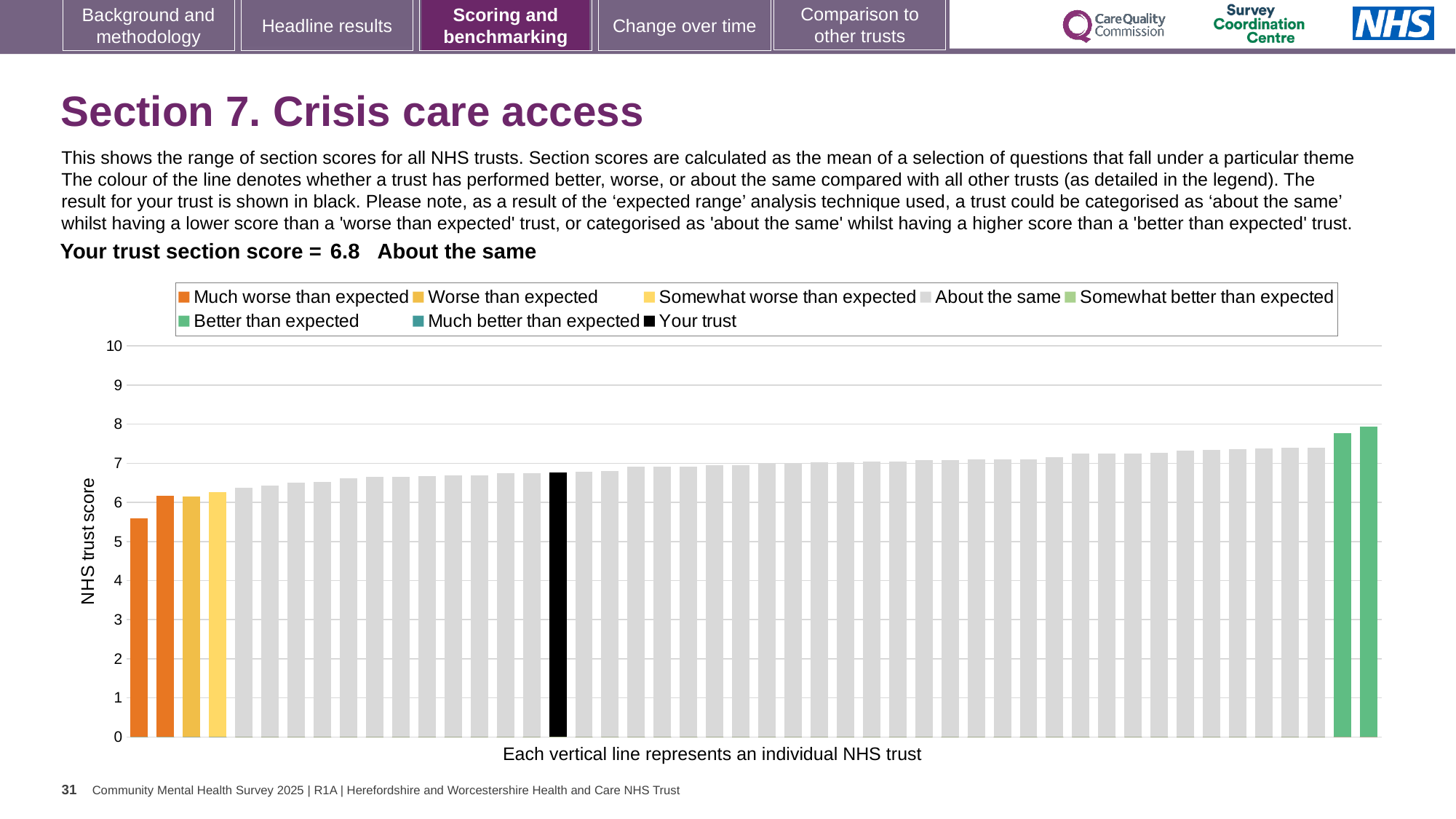
How many bars are coloured orange (Much worse than expected)? 2 How many entries does the chart legend list? 8 What kind of chart is shown on the slide? bar chart What is the label on the vertical axis of the chart? NHS trust score Which is larger: the black 'Your trust' bar or the leftmost orange bar? the black 'Your trust' bar What is the section score for your trust shown on the slide? 6.8 How many bars are coloured green (Better than expected)? 2 Is the value of the black 'Your trust' bar greater or less than 6? greater Is the value of the shortest bar in the chart greater or less than 6? less Do the bar values rise or fall from left to right along the x axis? rise Which category is your trust placed in for this section? About the same